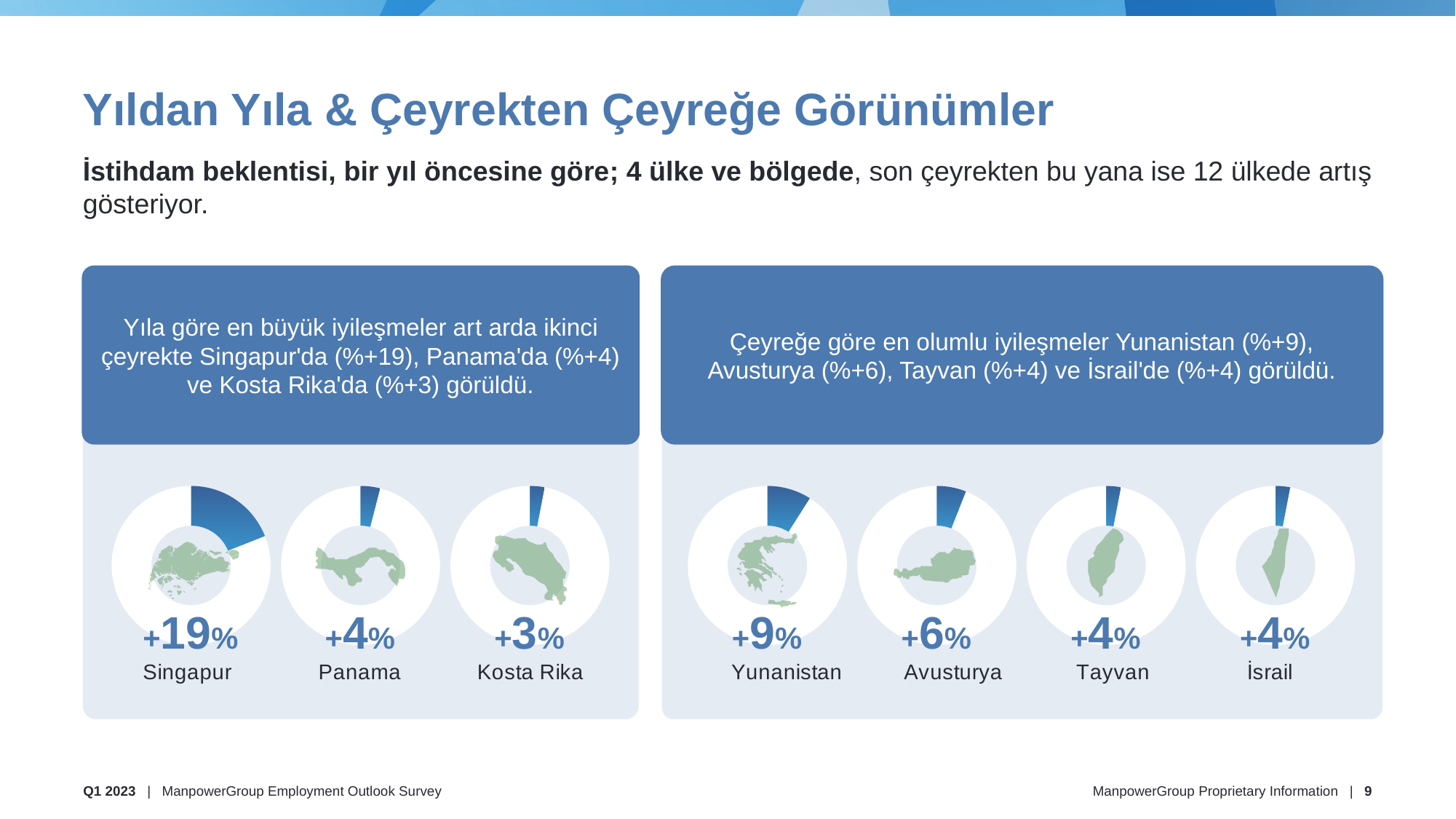
In the right panel (quarter-over-quarter improvements), what is the difference between the values for Yunanistan and Avusturya? 3 percentage points In the left panel (year-over-year improvements), what is the value shown for Panama? +4% In the right panel (quarter-over-quarter improvements), how many countries are shown? 4 In the left panel (year-over-year improvements), what is the value shown for Kosta Rika? +3% In the left panel (year-over-year improvements), what is the difference between the values for Singapur and Panama? 15 percentage points In the left panel (year-over-year improvements), which country has the highest value? Singapur In the right panel (quarter-over-quarter improvements), what is the value shown for Tayvan? +4% In the right panel (quarter-over-quarter improvements), what is the value shown for Yunanistan? +9% In the left panel (year-over-year improvements), what is the value shown for Singapur? +19% In the right panel (quarter-over-quarter improvements), what is the value shown for Avusturya? +6% In the left panel (year-over-year improvements), which is larger, the value for Panama or the value for Kosta Rika? Panama In the right panel (quarter-over-quarter improvements), which country has the highest value? Yunanistan